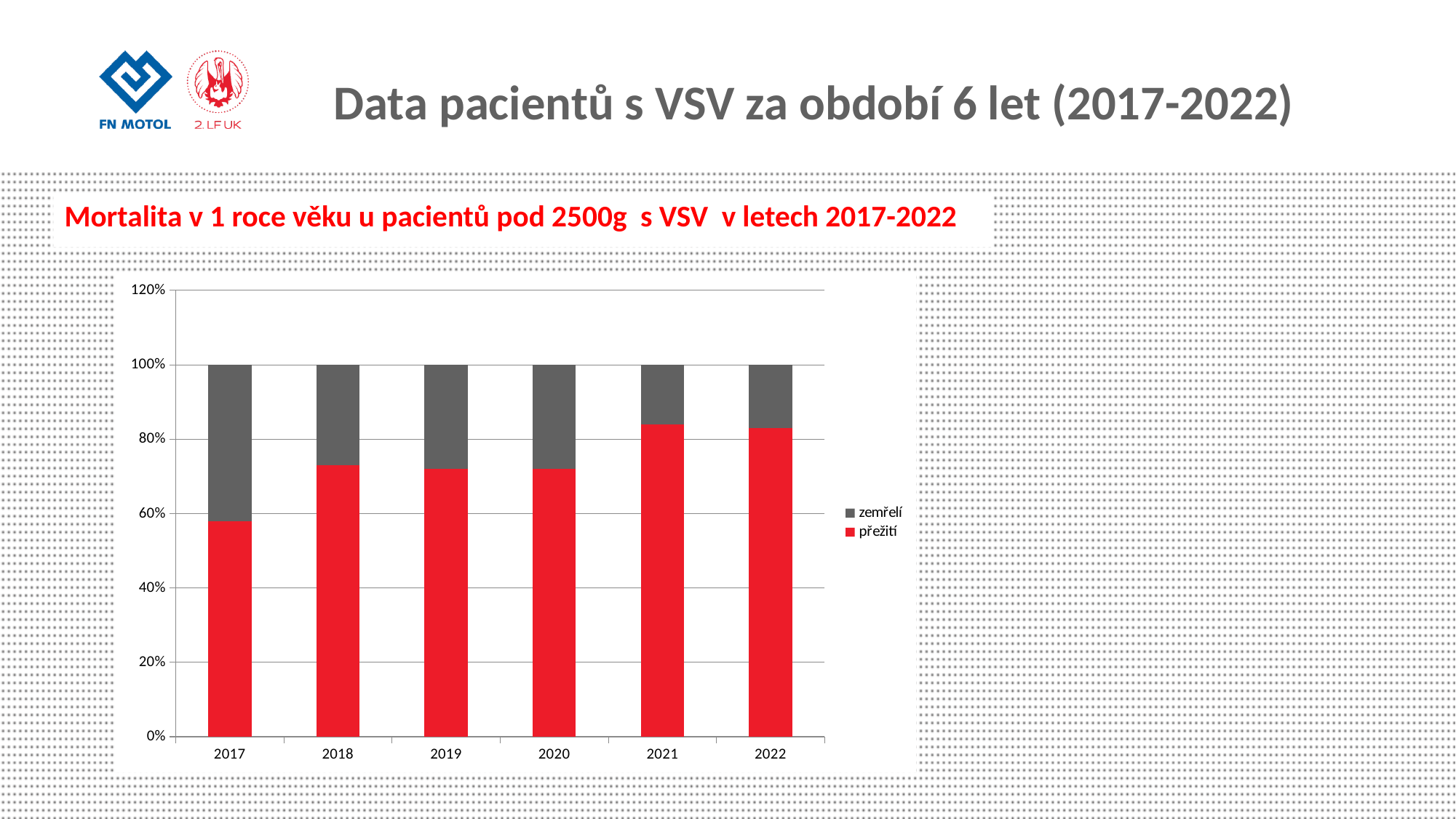
How many years are shown on the x axis of the chart? 6 Which year has the lowest share of přežití? 2017 How many series does the chart legend list? 2 Which year has the larger přežití share, 2017 or 2018? 2018 Is the přežití value for 2018 greater or less than 60%? greater Which colour represents přežití in the chart? red Which year has the highest share of zemřelí? 2017 Is the přežití value for 2021 greater or less than 80%? greater Is the zemřelí share for 2021 greater or less than 20%? less What kind of chart is shown on the slide? stacked bar chart What is the total height of each stacked bar in the chart? 100%